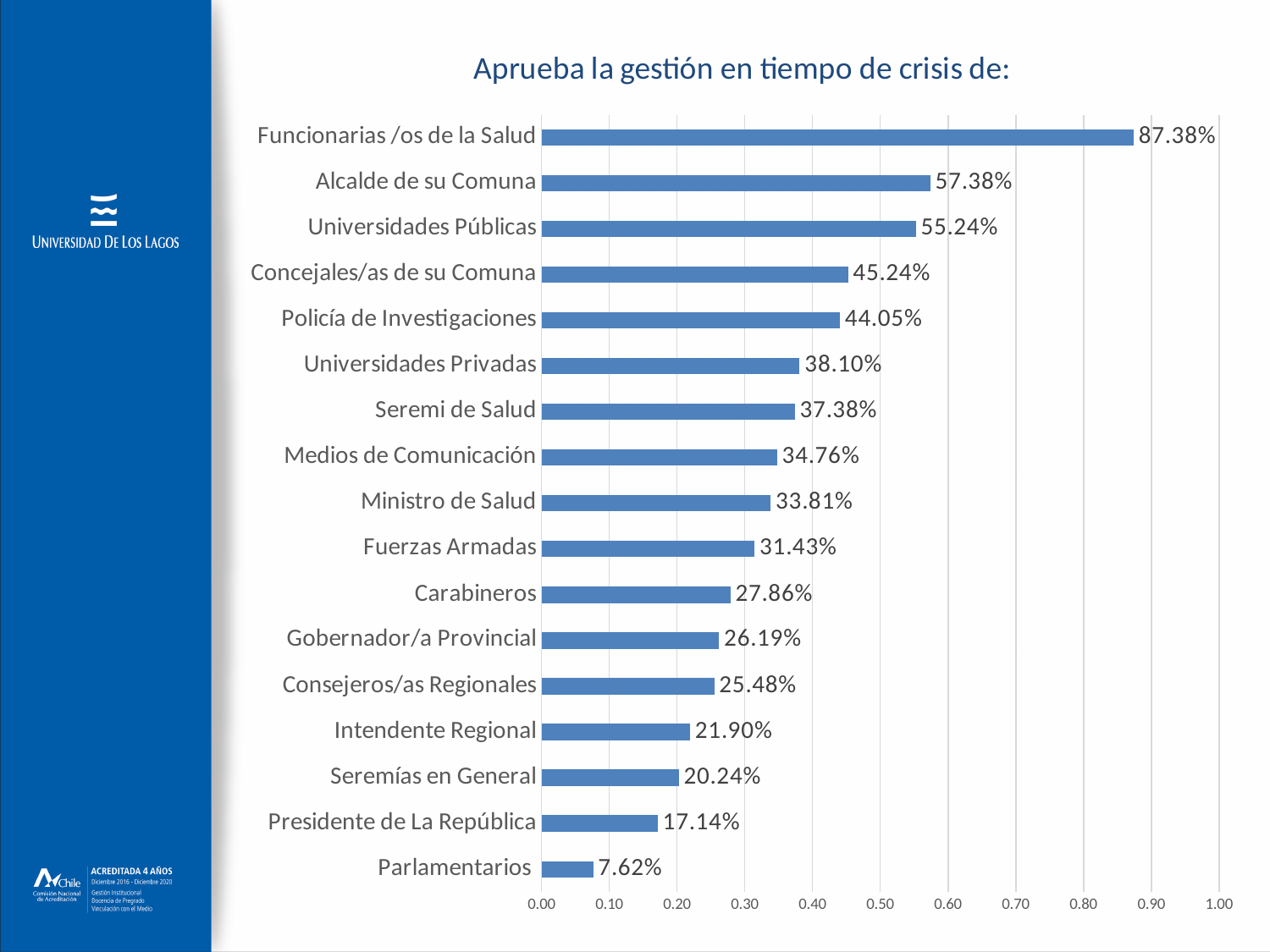
What is the title of the chart? Aprueba la gestión en tiempo de crisis de: What is the value for Funcionarias /os de la Salud? 87.38% What is the difference between the values for Funcionarias /os de la Salud and Alcalde de su Comuna? 30.00% Which is larger, the value for Universidades Públicas or the value for Universidades Privadas? Universidades Públicas What kind of chart is shown on the slide? Bar chart What is the difference between the values for Presidente de La República and Parlamentarios? 9.52% What is the value for Ministro de Salud? 33.81% Which category has the highest value? Funcionarias /os de la Salud Which category has the lowest value? Parlamentarios How many categories are shown in the chart? 17 Is the value for Carabineros greater or less than 0.30? less What is the value for Presidente de La República? 17.14%